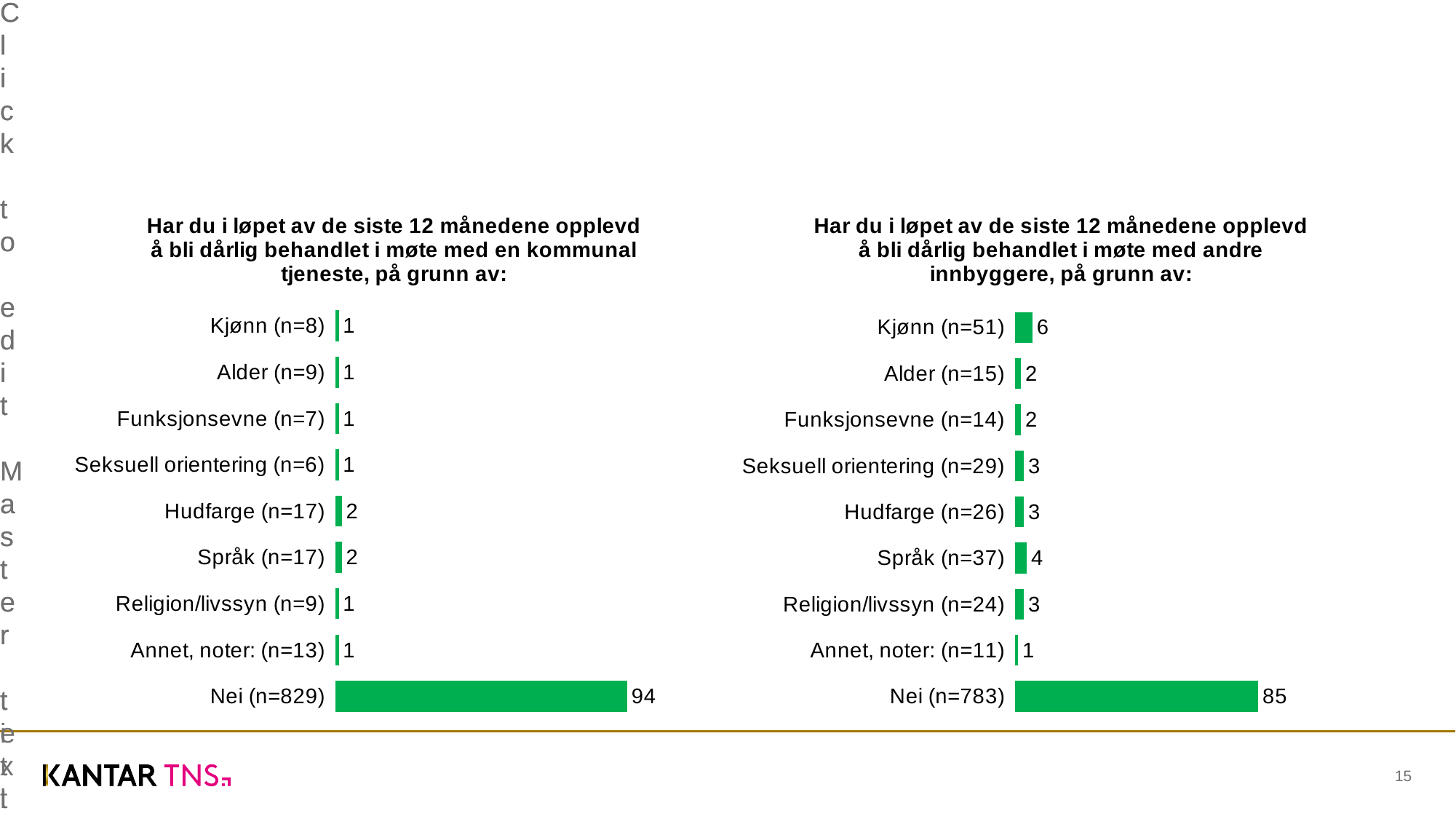
In the right chart (andre innbyggere), which category has the highest value? Nei (n=783) In the left chart (kommunal tjeneste), what is the value for Hudfarge (n=17)? 2 In the right chart (andre innbyggere), what is the value for Kjønn (n=51)? 6 In the right chart (andre innbyggere), what is the difference between Kjønn (6) and Alder (2)? 4 What colour are the bars in both charts? Green In the right chart (andre innbyggere), which category has the lowest value? Annet, noter: (n=11) How many categories are shown in the left chart (kommunal tjeneste)? 9 What type of chart is used on this slide? Bar chart What is the difference between the Nei value in the left chart (94) and the Nei value in the right chart (85)? 9 In the right chart (andre innbyggere), what is the value for Språk (n=37)? 4 In the left chart (kommunal tjeneste), what is the value for Nei (n=829)? 94 In the right chart (andre innbyggere), which is larger: Kjønn or Språk? Kjønn